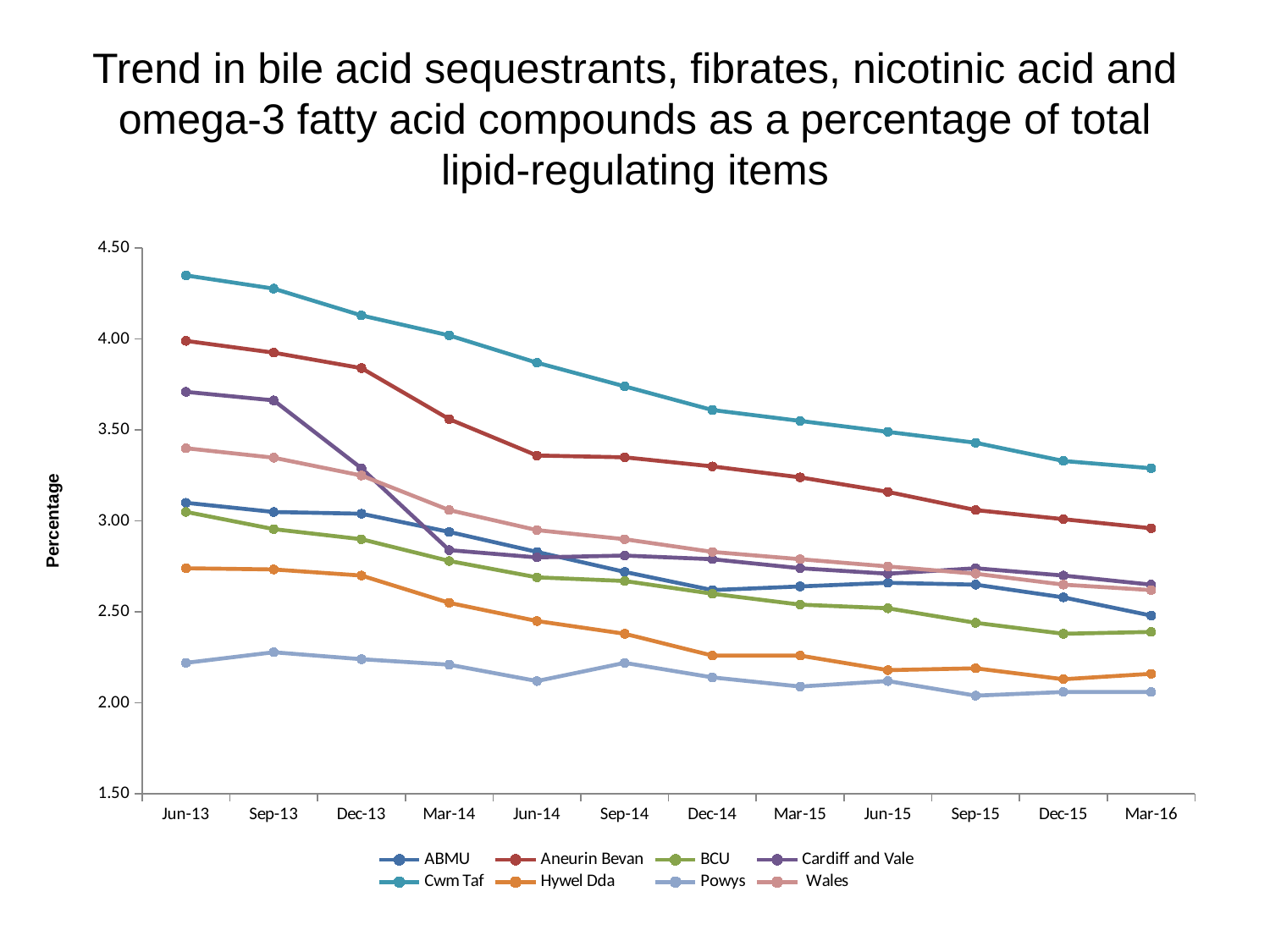
Is the value for Powys at Jun-13 greater or less than 2.50? less Is the value for Hywel Dda at Mar-16 greater or less than 2.50? less At Mar-16, which is larger: Aneurin Bevan or ABMU? Aneurin Bevan At Jun-13, which is larger: Cardiff and Vale or Hywel Dda? Cardiff and Vale What is the label on the y axis? Percentage Does the Cwm Taf line rise or fall from Jun-13 to Mar-16? fall How many time points are shown along the x axis? 12 Which series has the lowest value at Mar-16? Powys Is the value for Cwm Taf at Jun-13 greater or less than 4.00? greater What kind of chart is shown on the slide? line chart How many series does the legend list? 8 Which series has the highest value at Jun-13? Cwm Taf